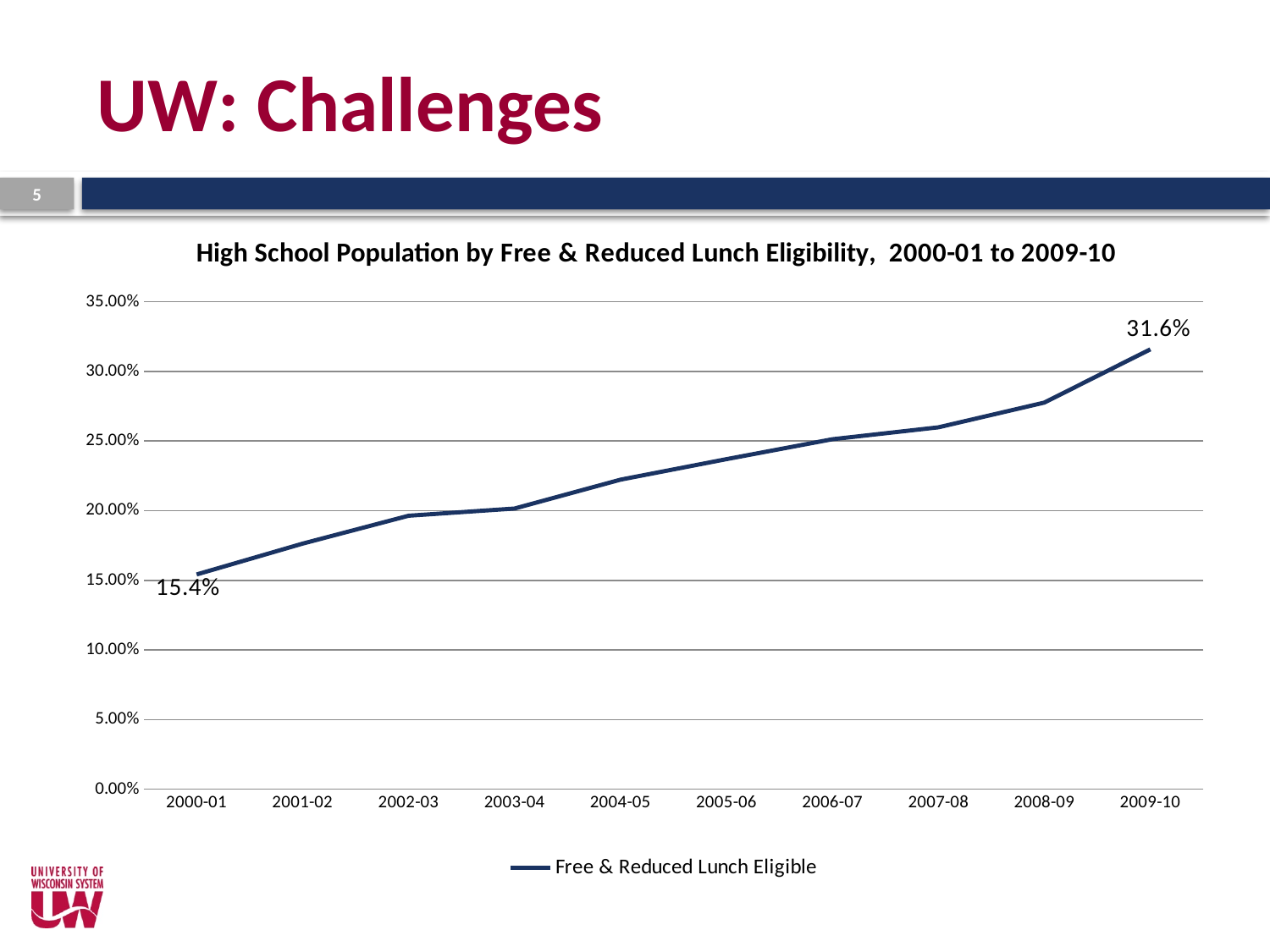
What is the value for 2009-10? 31.6% Which year has the highest value? 2009-10 What type of chart is shown on the slide? Line chart Is the value for 2004-05 greater or less than 20.00%? greater Is the value for 2008-09 greater or less than 30.00%? less What is the title of the chart? High School Population by Free & Reduced Lunch Eligibility, 2000-01 to 2009-10 What is the value for 2000-01? 15.4% Which year has the lowest value? 2000-01 Does the value rise or fall from 2000-01 to 2009-10? Rise How many school years are plotted on the x axis? 10 What is the difference between the values for 2009-10 and 2000-01? 16.2 percentage points How many series does the legend list? 1